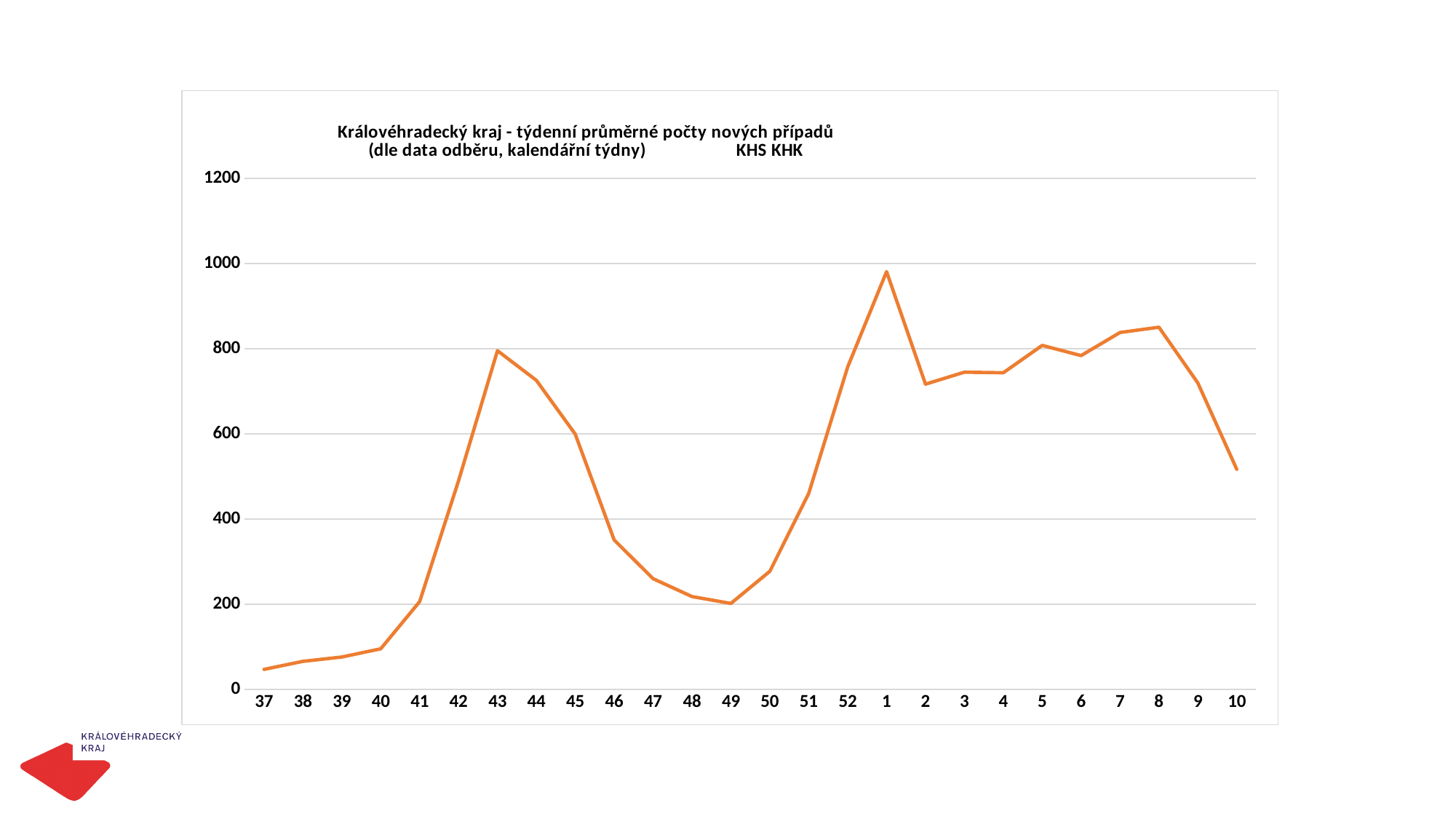
Is the value for week 49 greater or less than 400? less Is the value for week 1 greater or less than 800? greater Which week has the larger value, week 8 or week 2? 8 Which week has the lowest weekly average number of new cases? 37 Is the value for week 10 greater or less than 600? less What is the first line of the chart title? Královéhradecký kraj - týdenní průměrné počty nových případů Do the values rise or fall from week 8 to week 10? fall How many weeks (data points) are plotted along the x axis? 26 What kind of chart is shown on the slide? line chart Which week has the larger value, week 43 or week 46? 43 Which week has the highest weekly average number of new cases? 1